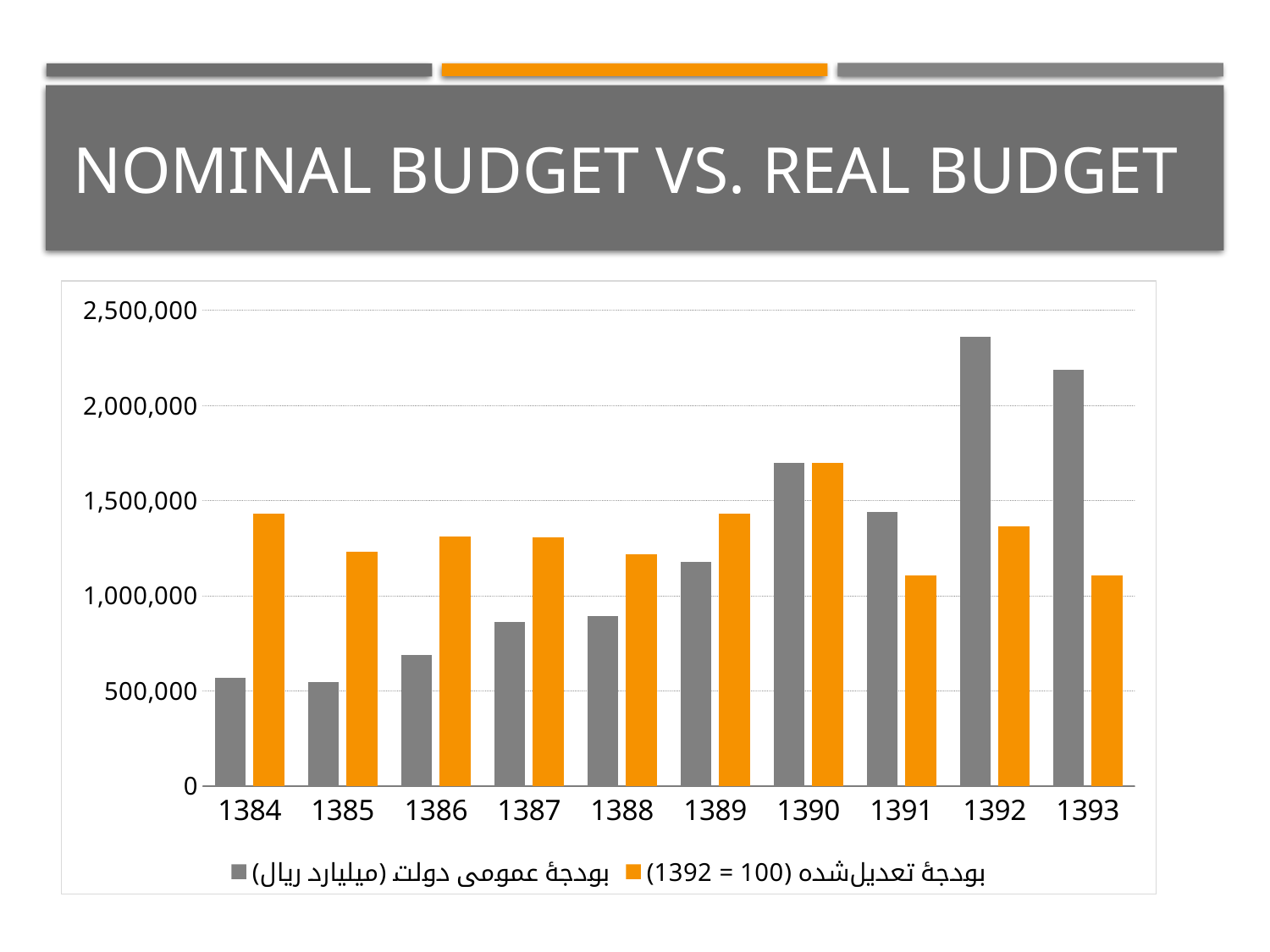
What is the title of the slide? NOMINAL BUDGET VS. REAL BUDGET Is the gray bar for 1392 greater or less than 2,000,000? greater In which year is the orange bar (بودجهٔ تعدیل‌شده) the highest? 1390 For 1393, which bar is taller, the gray bar or the orange bar? the gray bar Is the gray bar for 1386 greater or less than 1,000,000? less Is the orange bar for 1384 greater or less than 1,500,000? less How many years are shown on the x axis of the chart? 10 For 1384, which bar is taller, the gray bar or the orange bar? the orange bar How many series does the chart's legend list? 2 What kind of chart is shown on the slide? bar chart In which year is the gray bar (بودجهٔ عمومی دولت) the highest? 1392